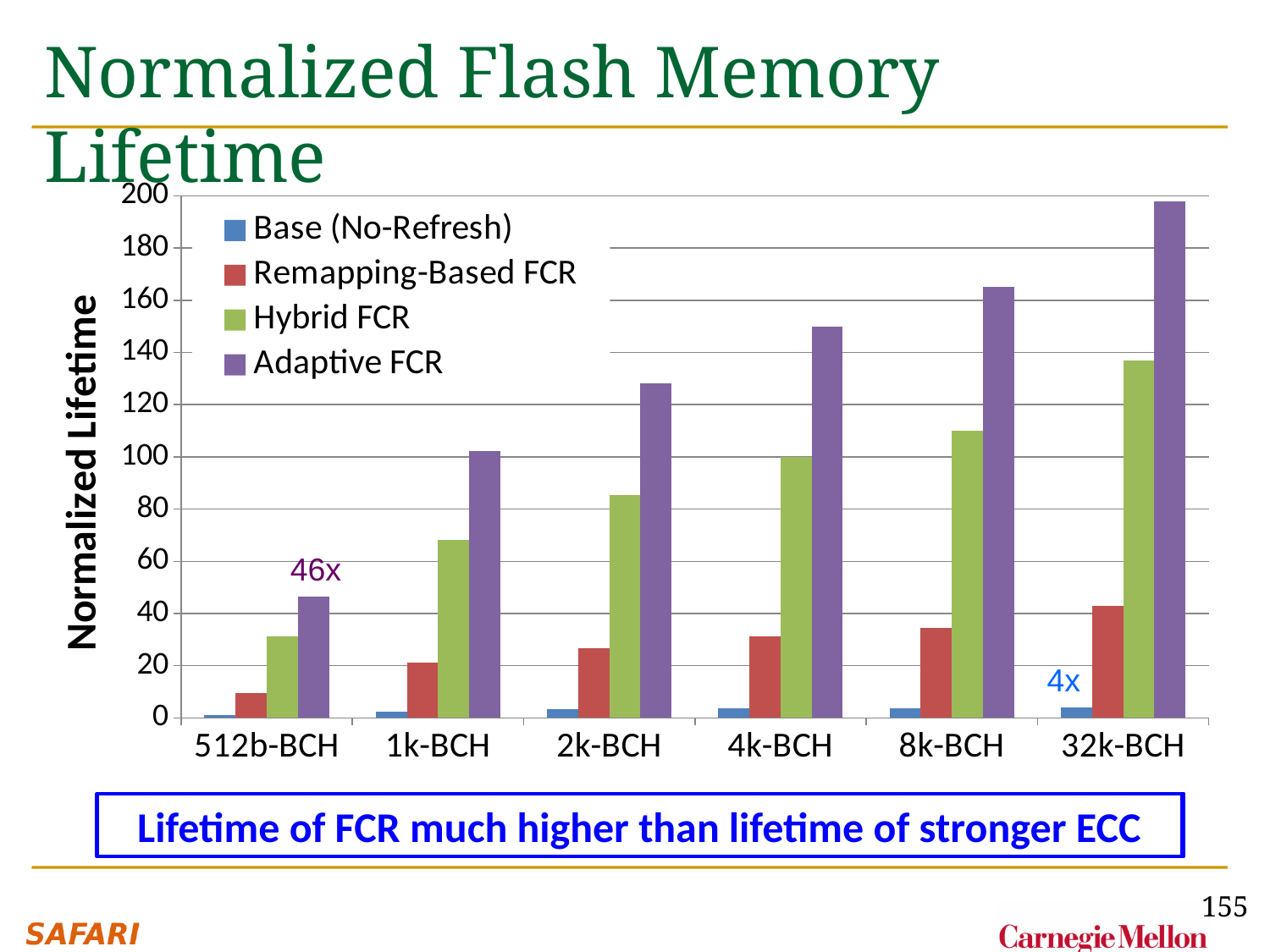
How many BCH categories are shown on the x axis? 6 Is the Hybrid FCR value for 1k-BCH greater or less than 80? less Which series has the lowest normalized lifetime at 512b-BCH? Base (No-Refresh) Is the Adaptive FCR value for 8k-BCH greater or less than 160? greater What is the title of the y axis? Normalized Lifetime Is the Remapping-Based FCR value for 32k-BCH greater or less than 40? greater Which series has the highest normalized lifetime at 32k-BCH? Adaptive FCR What kind of chart is shown on the slide? bar chart Which is larger at 2k-BCH, the Hybrid FCR value or the Remapping-Based FCR value? Hybrid FCR How many series does the legend list? 4 How does the Adaptive FCR normalized lifetime change from 512b-BCH to 32k-BCH? It rises What label is printed above the Adaptive FCR bar for 512b-BCH? 46x